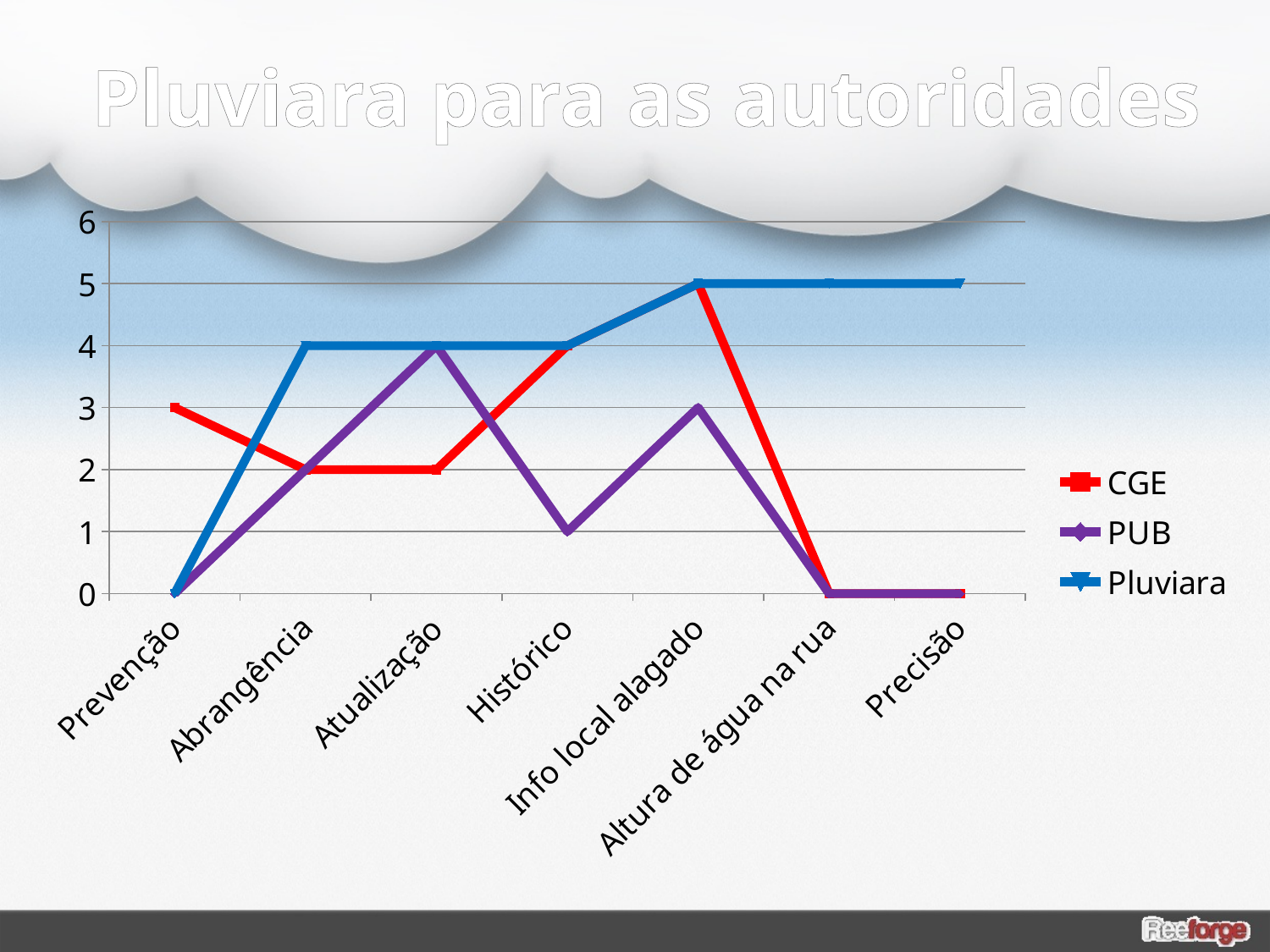
What is the value for Pluviara at Abrangência? 4 Which series is drawn in red? CGE What is the value for CGE at Altura de água na rua? 0 At which category does PUB reach its highest value? Atualização What is the value for CGE at Prevenção? 3 How many series does the legend list? 3 What is the difference between Pluviara and PUB at Info local alagado? 2 What kind of chart is shown on the slide? line chart Which series has the highest value at Precisão? Pluviara How many categories are shown on the x axis? 7 What is the value for PUB at Histórico? 1 Which is larger at Prevenção, CGE or PUB? CGE